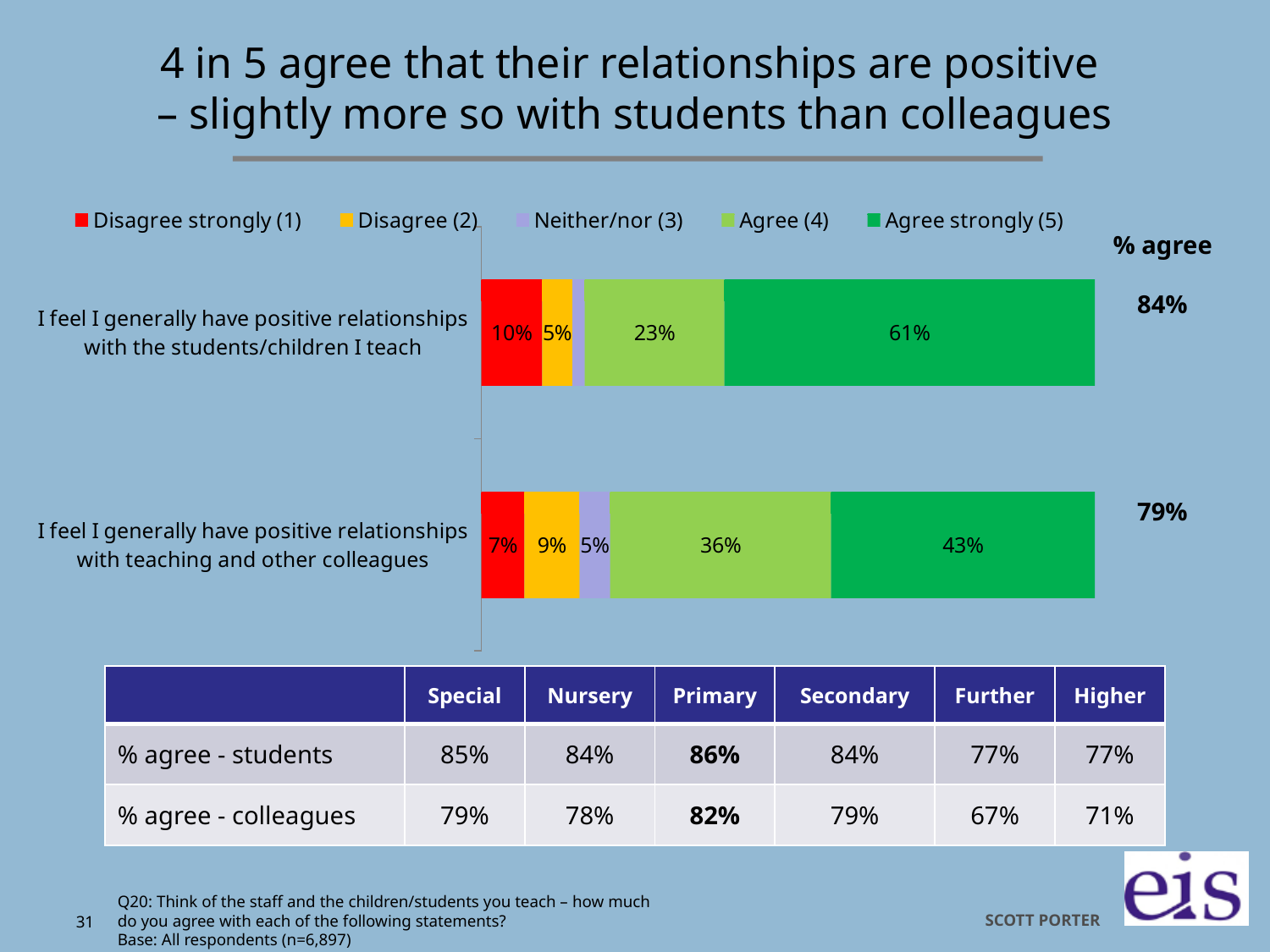
What is the 'Disagree strongly (1)' value for the statement about positive relationships with teaching and other colleagues? 7% What is the '% agree' figure shown for the statement about positive relationships with the students/children I teach? 84% What percentage of respondents 'Agree strongly (5)' that they have positive relationships with the students/children they teach? 61% What kind of chart is shown on the slide? Stacked bar chart What is the total of the stacked bar for the statement about positive relationships with teaching and other colleagues? 100% Which statement has the higher 'Disagree (2)' share? Relationships with teaching and other colleagues How many statements (categories) are plotted in the chart? 2 Which statement has the higher 'Agree strongly (5)' share: relationships with students/children or relationships with colleagues? Relationships with the students/children I teach How many series does the chart legend list? 5 What is the difference between the 'Agree strongly (5)' values for the students statement and the colleagues statement? 18% Which legend entry is shown in red? Disagree strongly (1) What percentage of respondents 'Agree (4)' that they have positive relationships with teaching and other colleagues? 36%